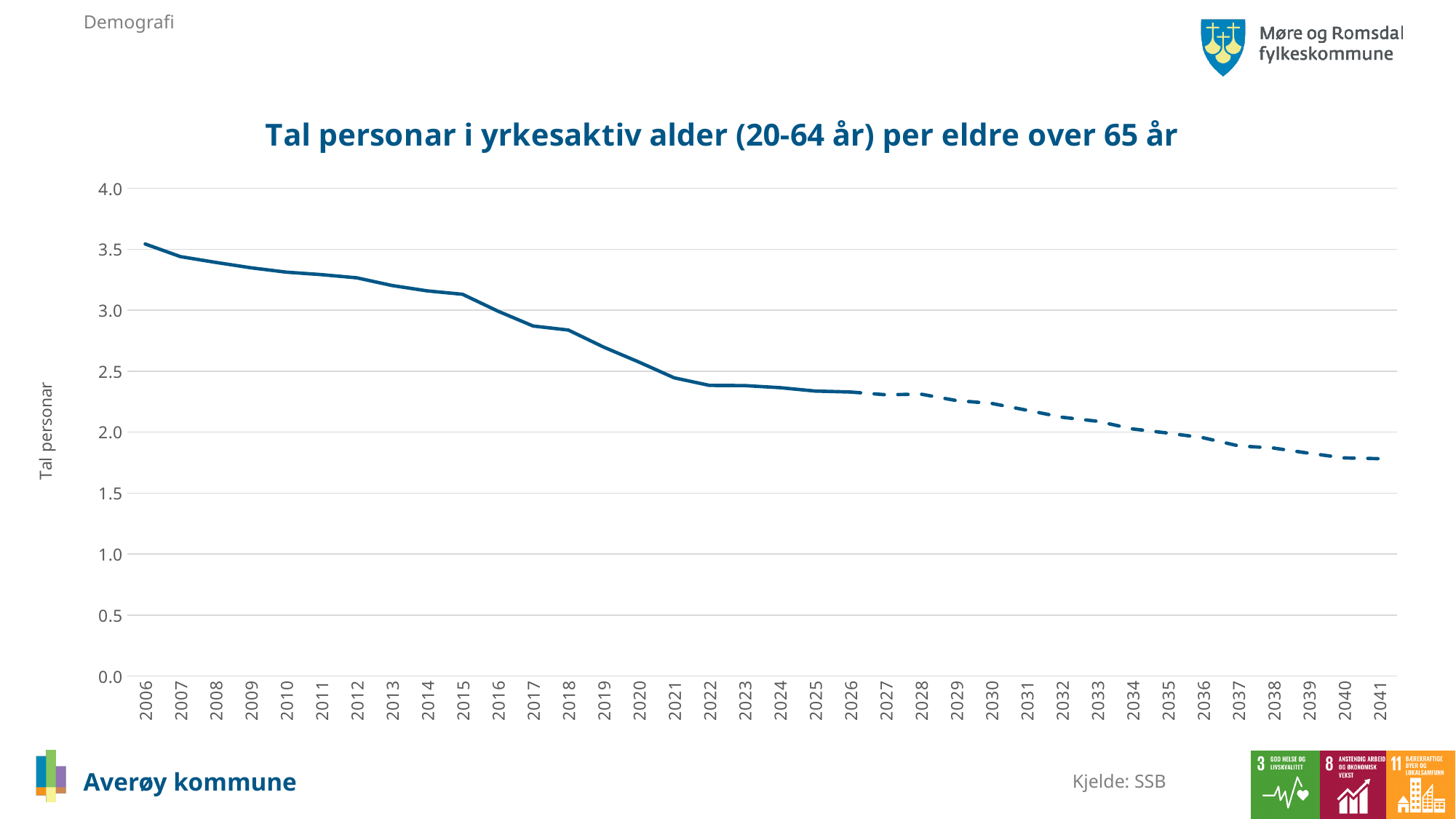
Which year has the lowest value on the chart? 2041 Is the value for 2041 greater or less than 2.0? less Is the value for 2030 greater or less than 2.0? greater Which year has the larger value, 2015 or 2020? 2015 Do the values rise or fall from 2006 to 2041? fall What kind of chart is shown on the slide? line chart What is the label on the vertical axis of the chart? Tal personar How many years are shown on the x axis of the chart? 36 Is the value for 2018 greater or less than 3.0? less Which year has the highest value on the chart? 2006 What is the title of the chart? Tal personar i yrkesaktiv alder (20-64 år) per eldre over 65 år